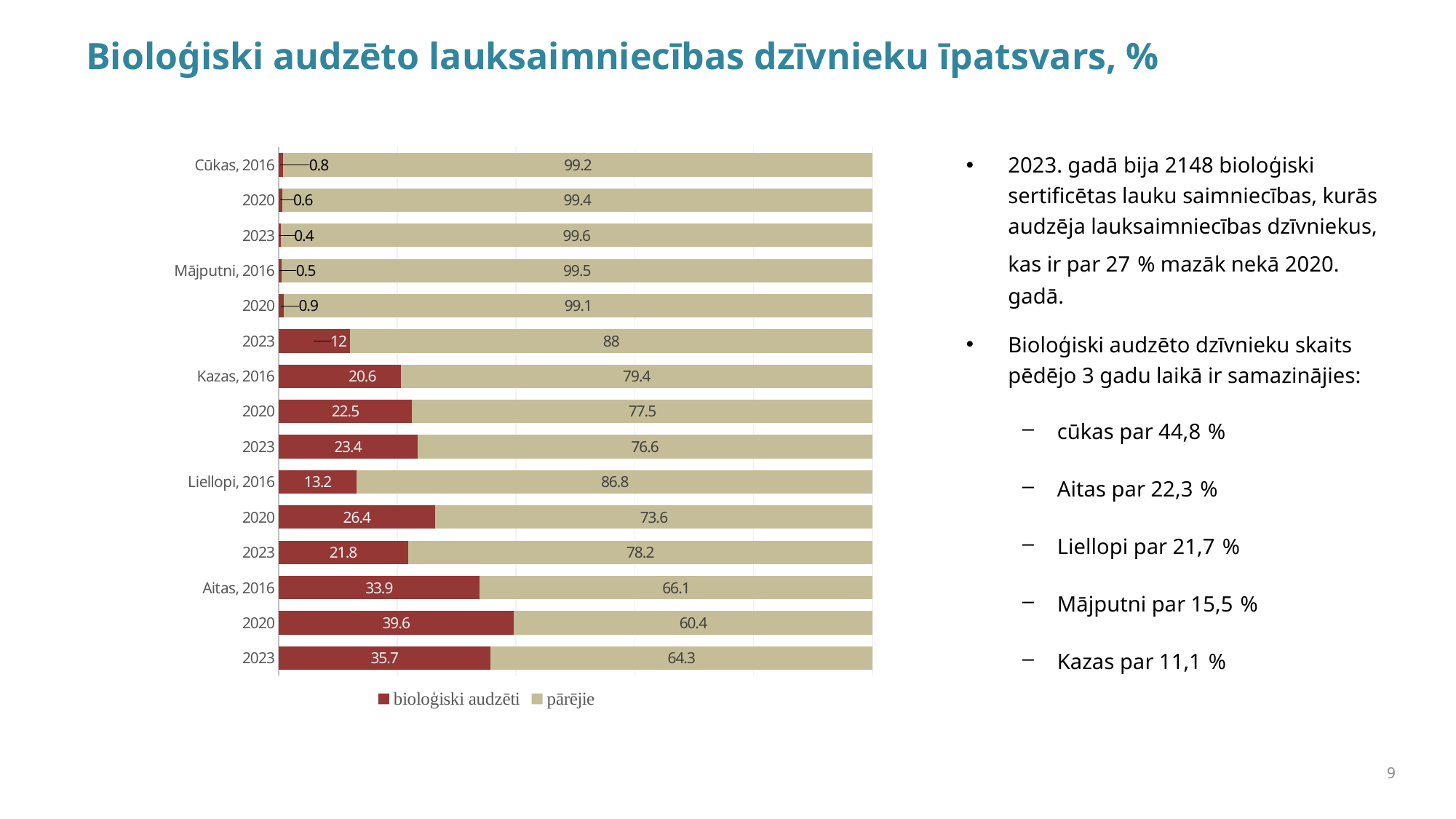
What kind of chart is shown on the slide? Stacked bar chart What is the value of "bioloģiski audzēti" for Mājputni, 2023? 12 What is the value of "pārējie" for Liellopi, 2016? 86.8 What is the total of the stacked bar for Kazas, 2016? 100 How many bars does the chart show? 15 Which bar has the highest "bioloģiski audzēti" value? Aitas, 2020 Which bar has the lowest "bioloģiski audzēti" value? Cūkas, 2023 What is the value of "bioloģiski audzēti" for Aitas, 2020? 39.6 What is the difference between the "bioloģiski audzēti" values for Liellopi, 2020 and Liellopi, 2023? 4.6 Which series is shown in dark red in the chart? bioloģiski audzēti Which is larger: the "bioloģiski audzēti" value for Kazas, 2023 or for Liellopi, 2023? Kazas, 2023 How many series does the legend list? 2